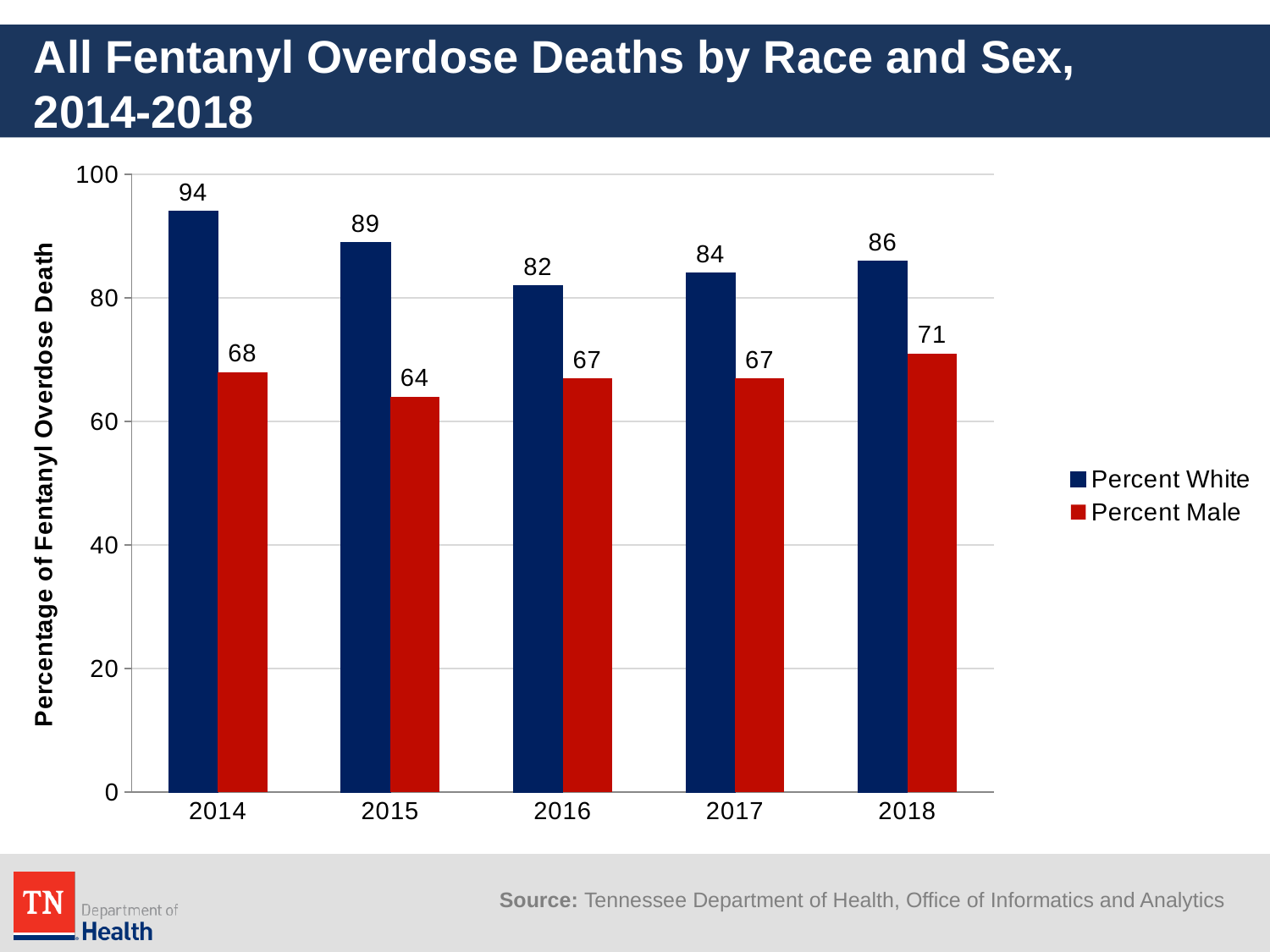
Which year has the highest Percent White value? 2014 How many years are shown on the x axis? 5 Is the Percent White value for 2016 larger than the Percent White value for 2017? No What is the label of the y axis? Percentage of Fentanyl Overdose Death What is the Percent Male value for 2018? 71 Which year has the lowest Percent Male value? 2015 What is the Percent Male value for 2015? 64 What kind of chart is shown on the slide? Bar chart What is the difference between Percent White and Percent Male in 2014? 26 Which year has the lowest Percent White value? 2016 How many series does the legend list? 2 What is the Percent White value for 2014? 94